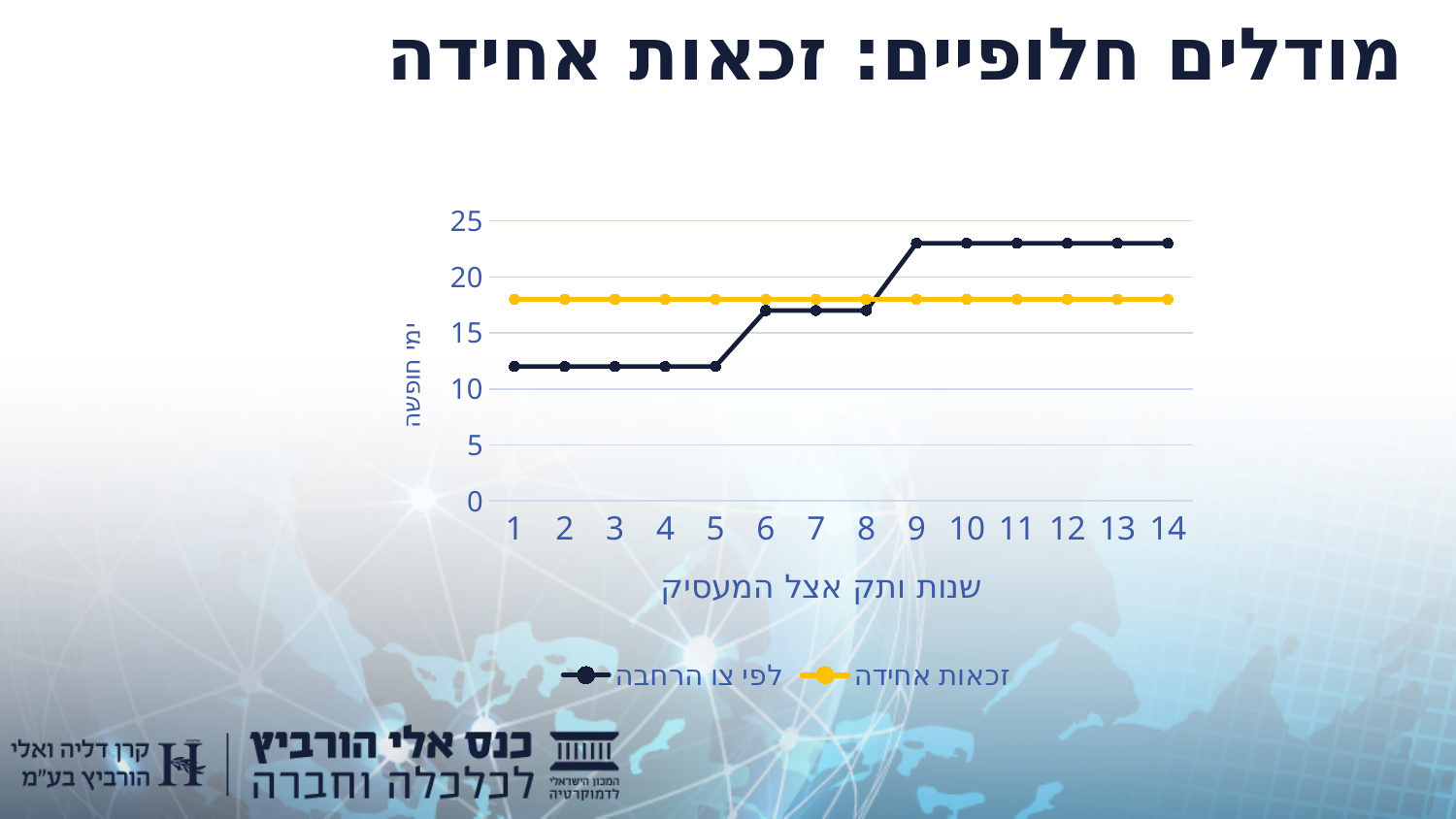
Is the value of the לפי צו הרחבה series at year 1 greater or less than 15? less Is the value of the זכאות אחידה series at year 5 greater or less than 15? greater What is the title of the chart's x axis? שנות ותק אצל המעסיק At year 3, which series has the higher value? זכאות אחידה How many points along the x axis (years of seniority) does the chart show? 14 At year 13, which series has the higher value? לפי צו הרחבה How many series does the legend list? 2 Is the value of the זכאות אחידה series at year 10 greater or less than 20? less What kind of chart is shown on the slide? line chart Does the לפי צו הרחבה series rise or fall as years of seniority increase? rise